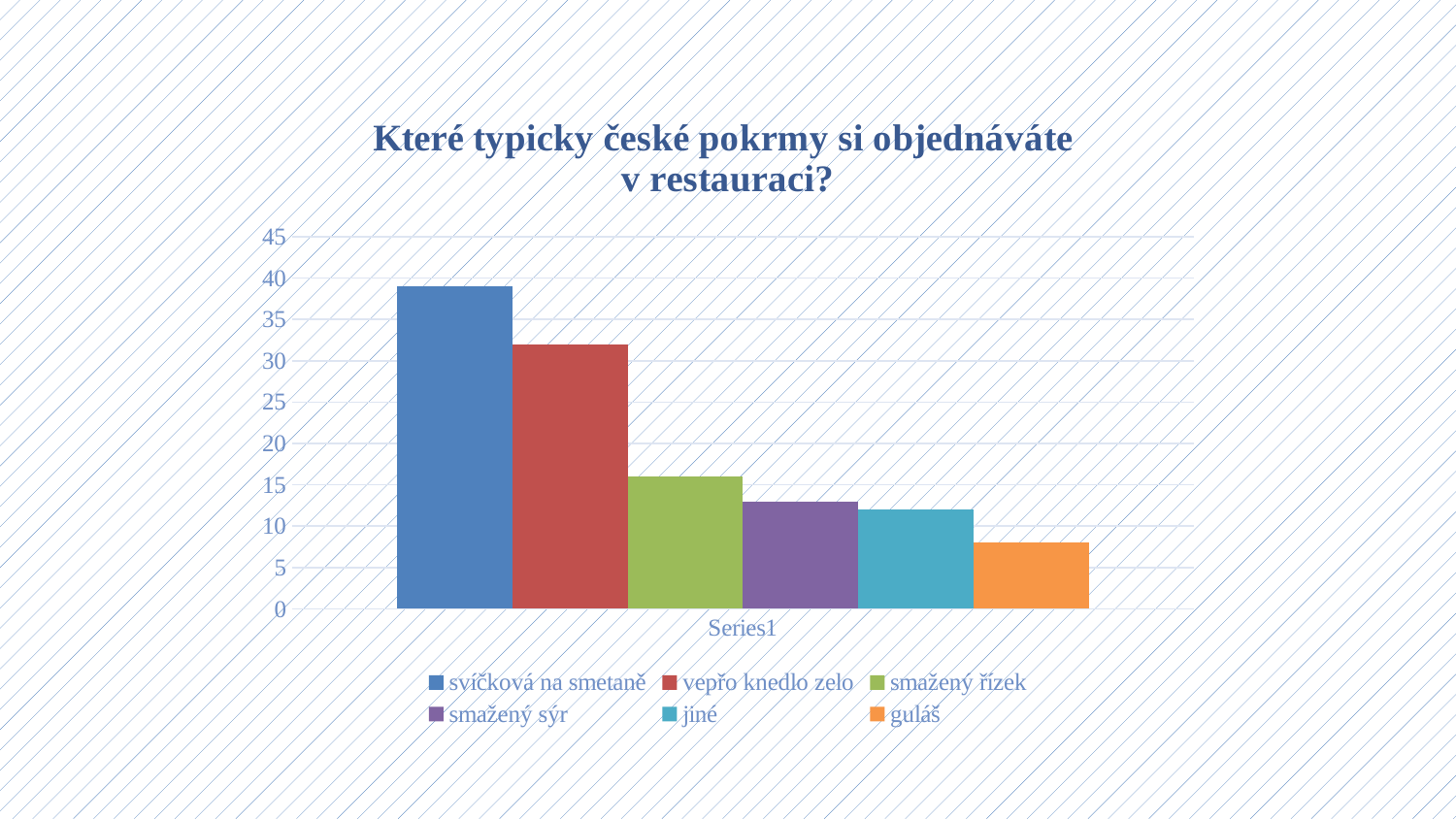
What kind of chart is shown on the slide? bar chart Which is larger, the value for svíčková na smetaně or for vepřo knedlo zelo? svíčková na smetaně Is the value for smažený řízek greater or less than 20? less How many series does the legend list? 6 Is the value for guláš greater or less than 10? less How many bars are plotted in the chart? 6 Is the value for svíčková na smetaně greater or less than 35? greater Which is larger, the value for smažený řízek or for guláš? smažený řízek Which dish has the highest bar? svíčková na smetaně Which dish has the lowest bar? guláš What is the title of the chart? Které typicky české pokrmy si objednáváte v restauraci?